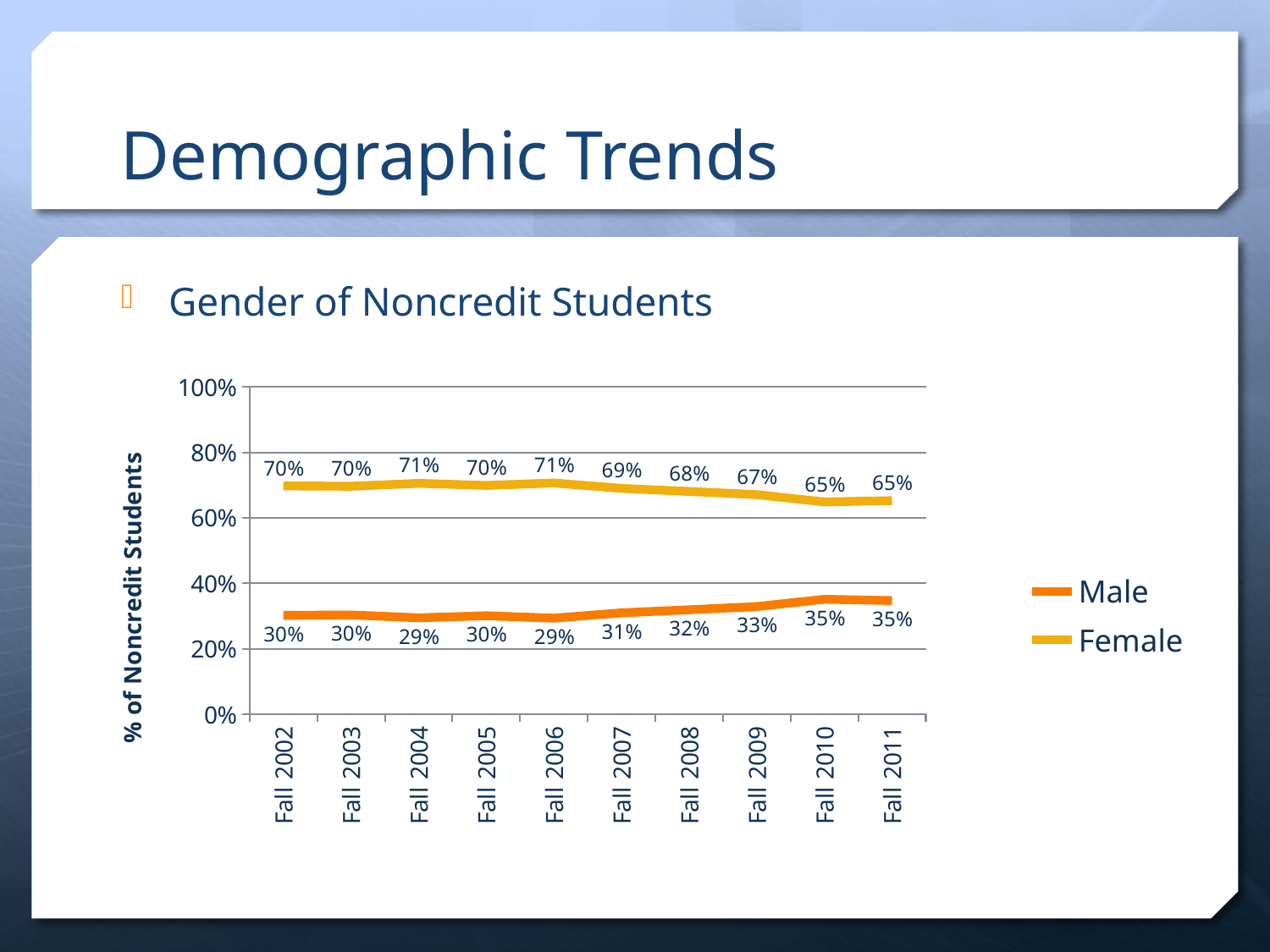
What kind of chart is this? line chart What is the Male value for Fall 2011? 35% What is the difference between the Female and Male values in Fall 2009? 34% How many series does the legend list? 2 Is the Female value for Fall 2011 greater or less than 60%? greater What is the lowest value in the Male series? 29% Does the Male series generally rise or fall from Fall 2002 to Fall 2011? rise How many years are shown on the x axis? 10 What is the Female value for Fall 2002? 70% In which year(s) does the Female series reach its highest value? Fall 2004 and Fall 2006 What is the Male value for Fall 2007? 31% Which is larger in Fall 2010, the Male value or the Female value? Female